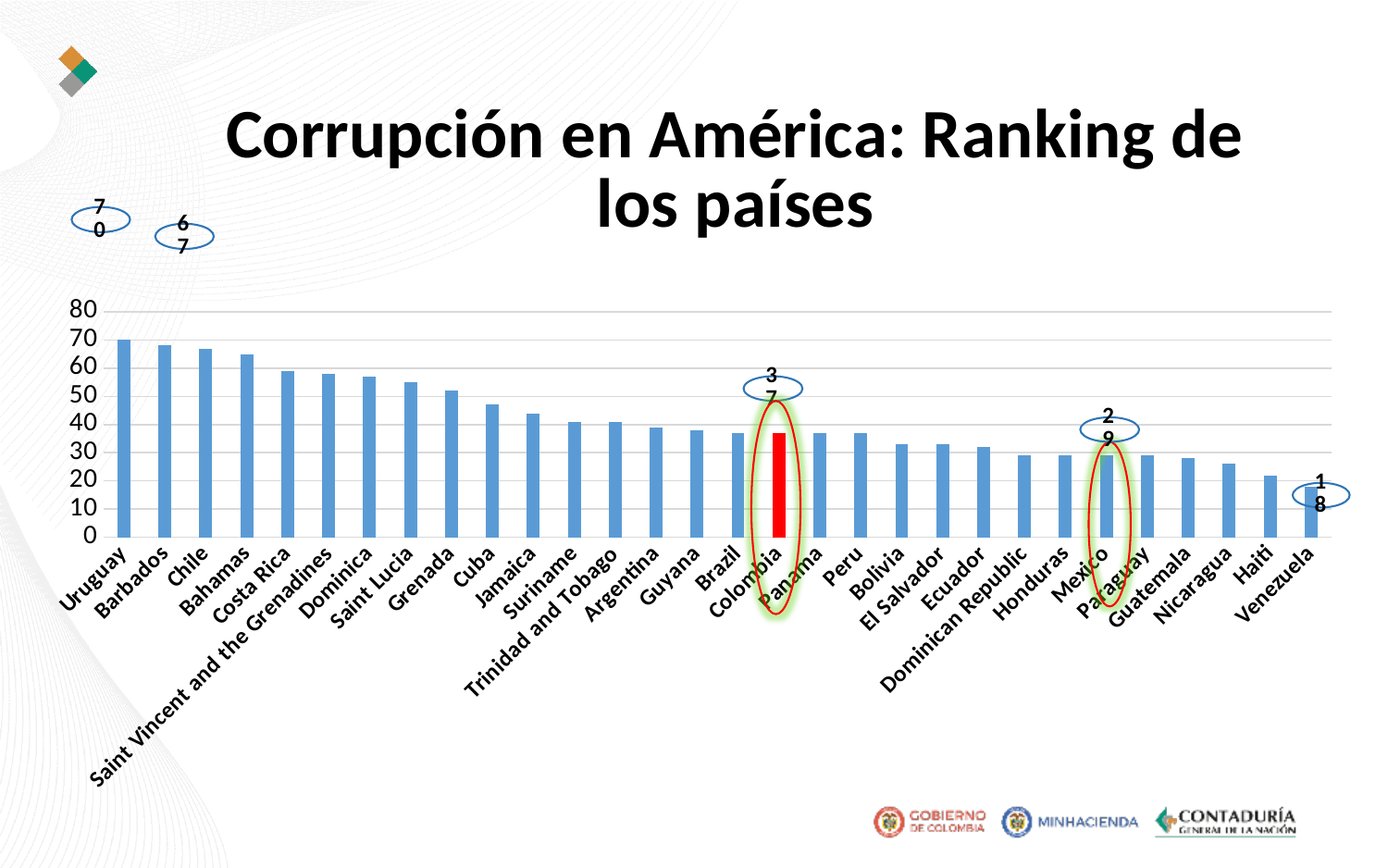
What is the difference between the values for Colombia and Venezuela? 19 What is the value shown for Colombia? 37 What kind of chart is shown on the slide? bar chart How many countries are shown in the chart? 30 What is the value shown for Venezuela? 18 Which has a larger value, Chile or Haiti? Chile What is the value shown for Mexico? 29 Which country has the highest value in the chart? Uruguay Which country has the lowest value in the chart? Venezuela Is the value for Haiti greater or less than 30? less What is the difference between the values for Colombia and Mexico? 8 Is the value for Costa Rica greater or less than 50? greater